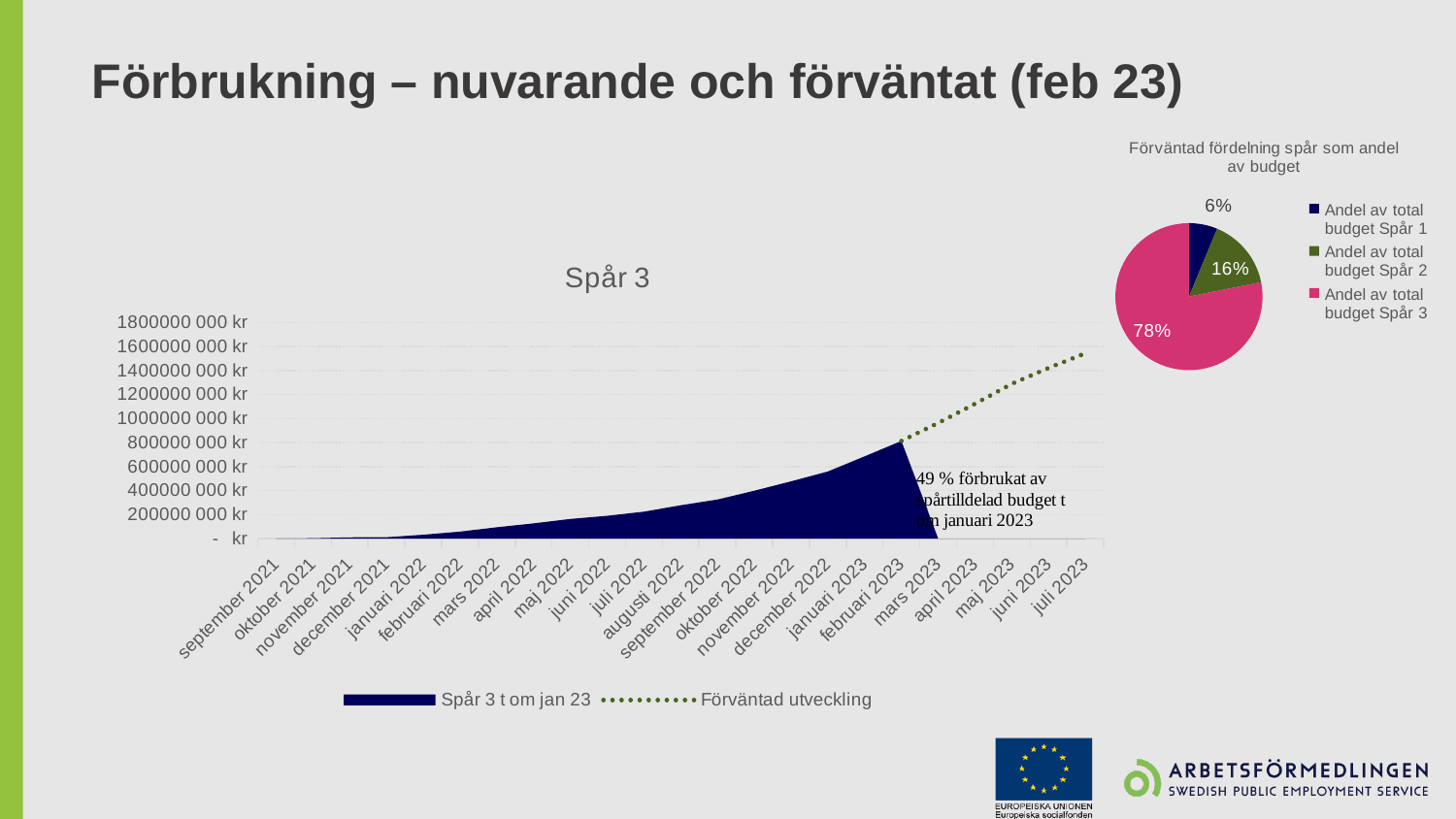
In the chart titled 'Spår 3', is the expected value (Förväntad utveckling) for juli 2023 greater or less than 1200000 000 kr? greater In the pie chart 'Förväntad fördelning spår som andel av budget', what share is shown for Andel av total budget Spår 2? 16% In the chart titled 'Spår 3', how many series does the legend list? 2 In the pie chart 'Förväntad fördelning spår som andel av budget', what share is shown for Andel av total budget Spår 3? 78% In the chart titled 'Spår 3', how many months are shown on the x axis? 23 In the chart titled 'Spår 3', do the values rise or fall from september 2021 to juli 2023? rise In the pie chart 'Förväntad fördelning spår som andel av budget', which slice is the largest? Andel av total budget Spår 3 In the pie chart 'Förväntad fördelning spår som andel av budget', what is the difference in percentage points between Spår 3 and Spår 2? 62 percentage points What kind of chart is the chart titled 'Spår 3'? Combination area and line chart (a filled area plus a dotted line) In the pie chart 'Förväntad fördelning spår som andel av budget', which slice is the smallest? Andel av total budget Spår 1 In the pie chart 'Förväntad fördelning spår som andel av budget', how many slices are there? 3 In the pie chart 'Förväntad fördelning spår som andel av budget', what share is shown for Andel av total budget Spår 1? 6%